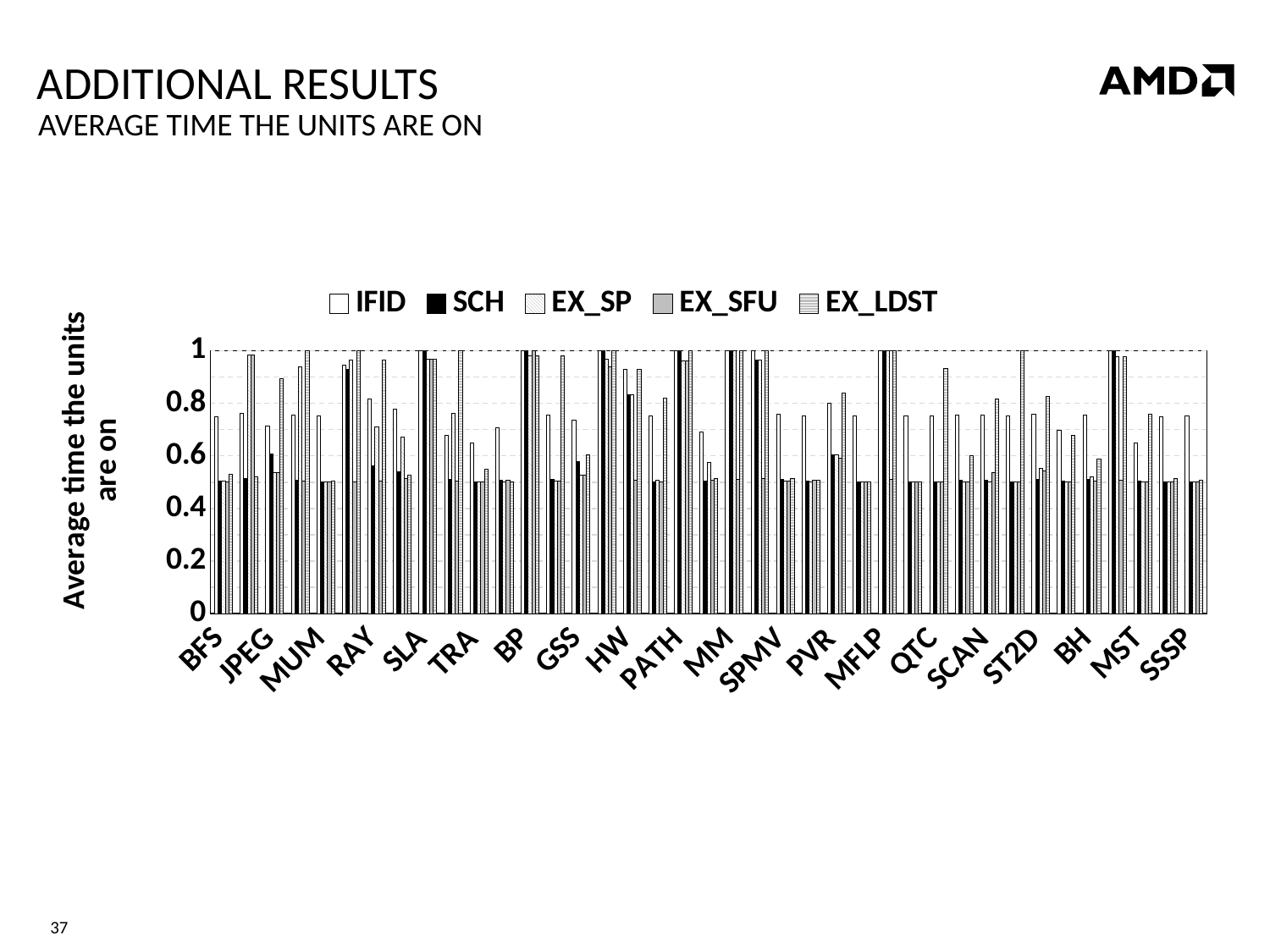
What kind of chart is shown on the slide? bar chart What is the label of the y axis? Average time the units are on Is the IFID value for BFS greater or less than 0.6? greater Which is larger for BFS, the IFID value or the SCH value? IFID Is the EX_SP value for JPEG greater or less than 0.8? less Is the IFID value for MM greater or less than 0.8? greater Which series is listed first in the legend? IFID Which is larger, the SCH value for BP or the SCH value for SSSP? BP How many series does the legend list? 5